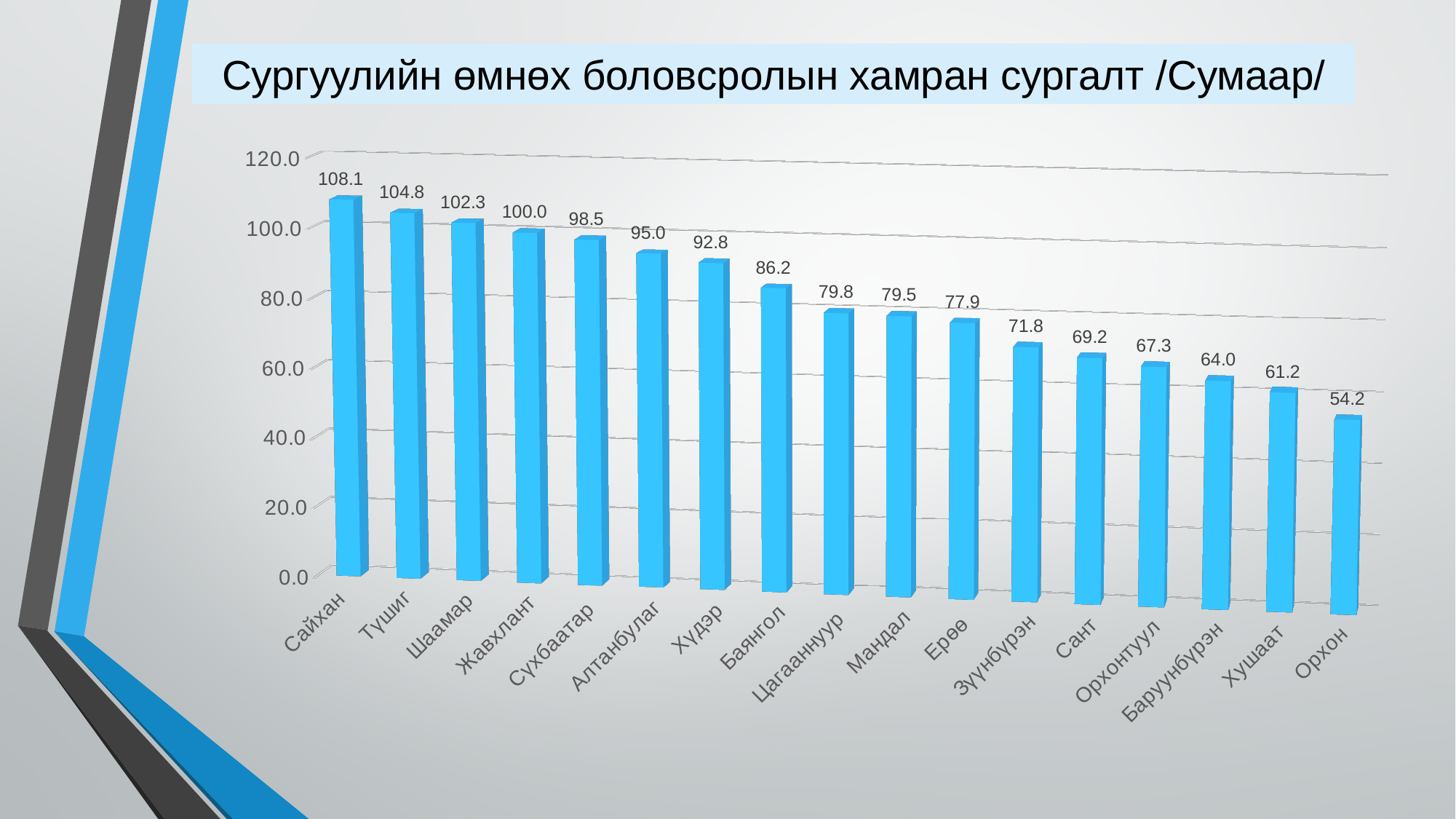
What is the value for Орхонтуул? 67.3 Which category has the highest value? Сайхан What kind of chart is shown on the slide? Bar chart Which is larger, the value for Зүүнбүрэн or the value for Хушаат? Зүүнбүрэн What is the difference between the values for Жавхлант and Хүдэр? 7.2 What is the value for Баянгол? 86.2 What is the value for Сайхан? 108.1 What is the difference between the values for Сайхан and Орхон? 53.9 Do the values rise or fall from left to right along the x axis? Fall How many categories are shown on the x axis? 17 Is the value for Алтанбулаг greater or less than 80.0? greater Which category has the lowest value? Орхон